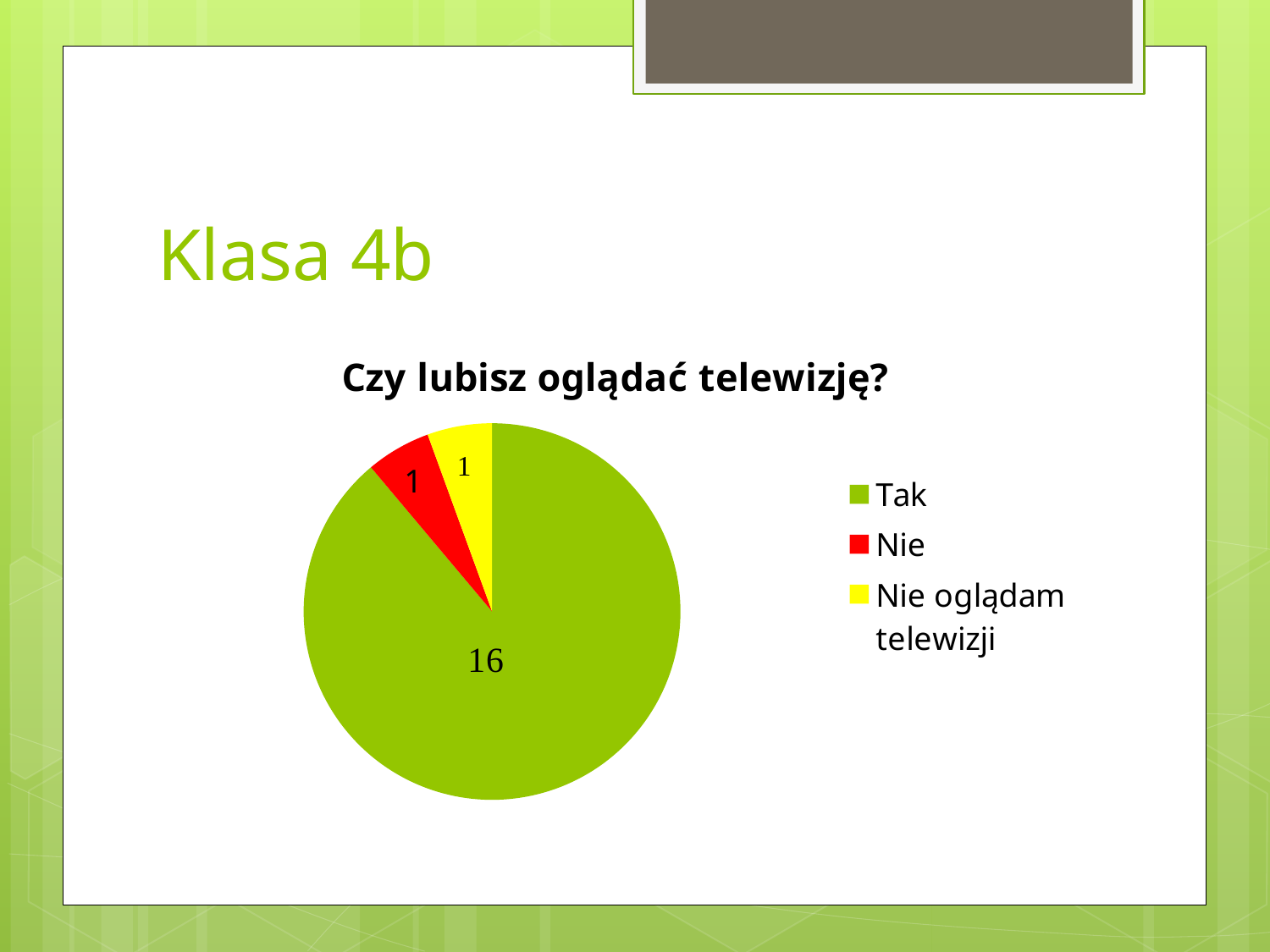
What is the difference between the values for "Tak" and "Nie"? 15 Which is larger, the value for "Tak" or the value for "Nie oglądam telewizji"? Tak What is the total of all slices in the pie chart? 18 What colour is the slice for "Nie"? red What is the value for "Nie"? 1 What type of chart is shown on the slide? pie chart What is the title of the chart? Czy lubisz oglądać telewizję? How many entries does the legend list? 3 How many slices does the pie chart have? 3 What is the value for "Tak"? 16 What is the value for "Nie oglądam telewizji"? 1 Which category has the largest slice? Tak